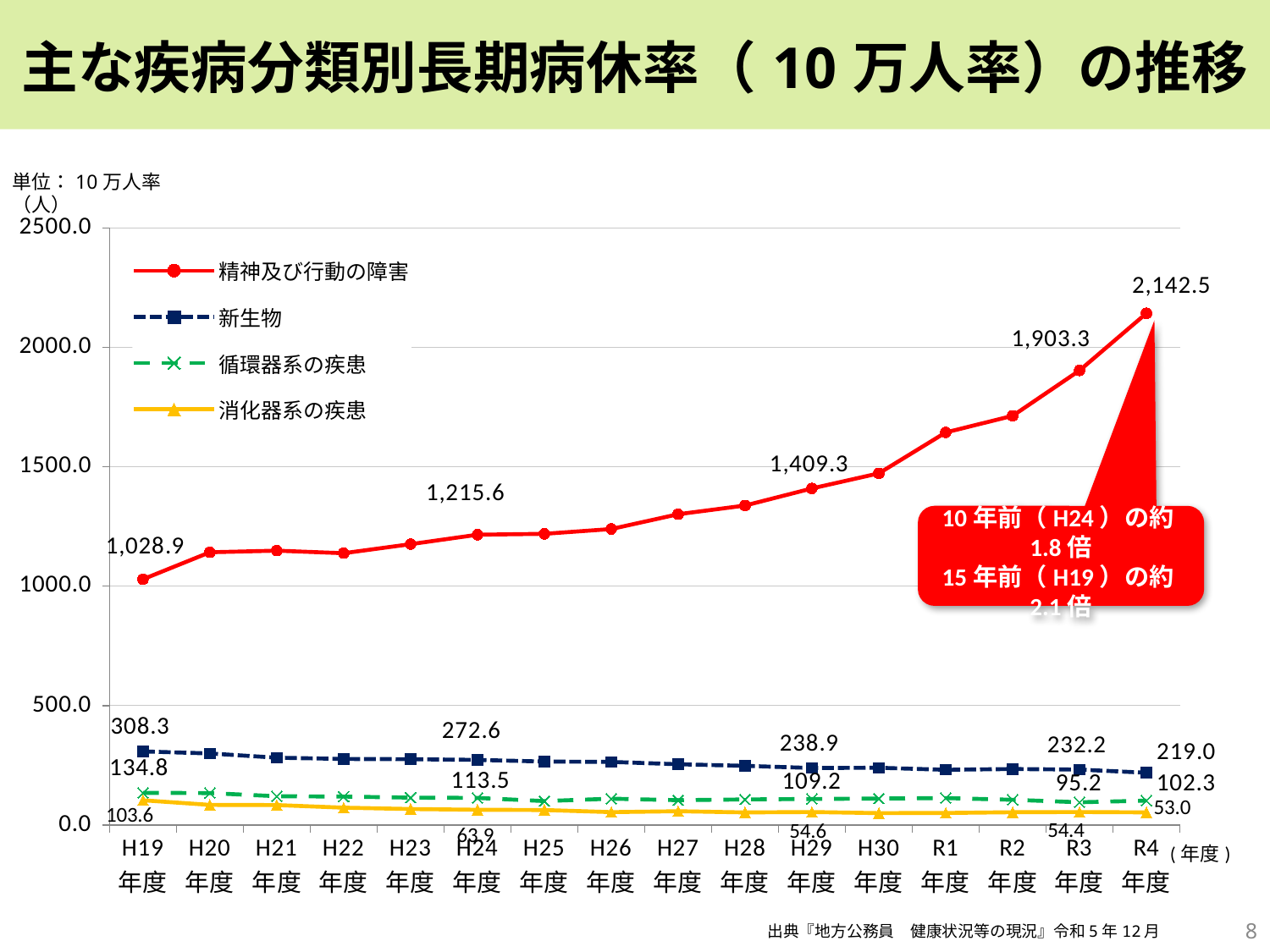
How many series does the legend list? 4 What is the value for 消化器系の疾患 in H29年度? 54.6 Does the 精神及び行動の障害 series rise or fall from H19年度 to R4年度? rise Which series has the lowest value in H19年度? 消化器系の疾患 What is the difference between the 精神及び行動の障害 values in R4年度 and R3年度? 239.2 What is the value for 精神及び行動の障害 in H19年度? 1,028.9 What is the value for 新生物 in H24年度? 272.6 What is the value for 循環器系の疾患 in R3年度? 95.2 Which series has the highest value in R4年度? 精神及び行動の障害 What is the value for 精神及び行動の障害 in R4年度? 2,142.5 Which is larger: the 新生物 value in H19年度 or in R4年度? H19年度